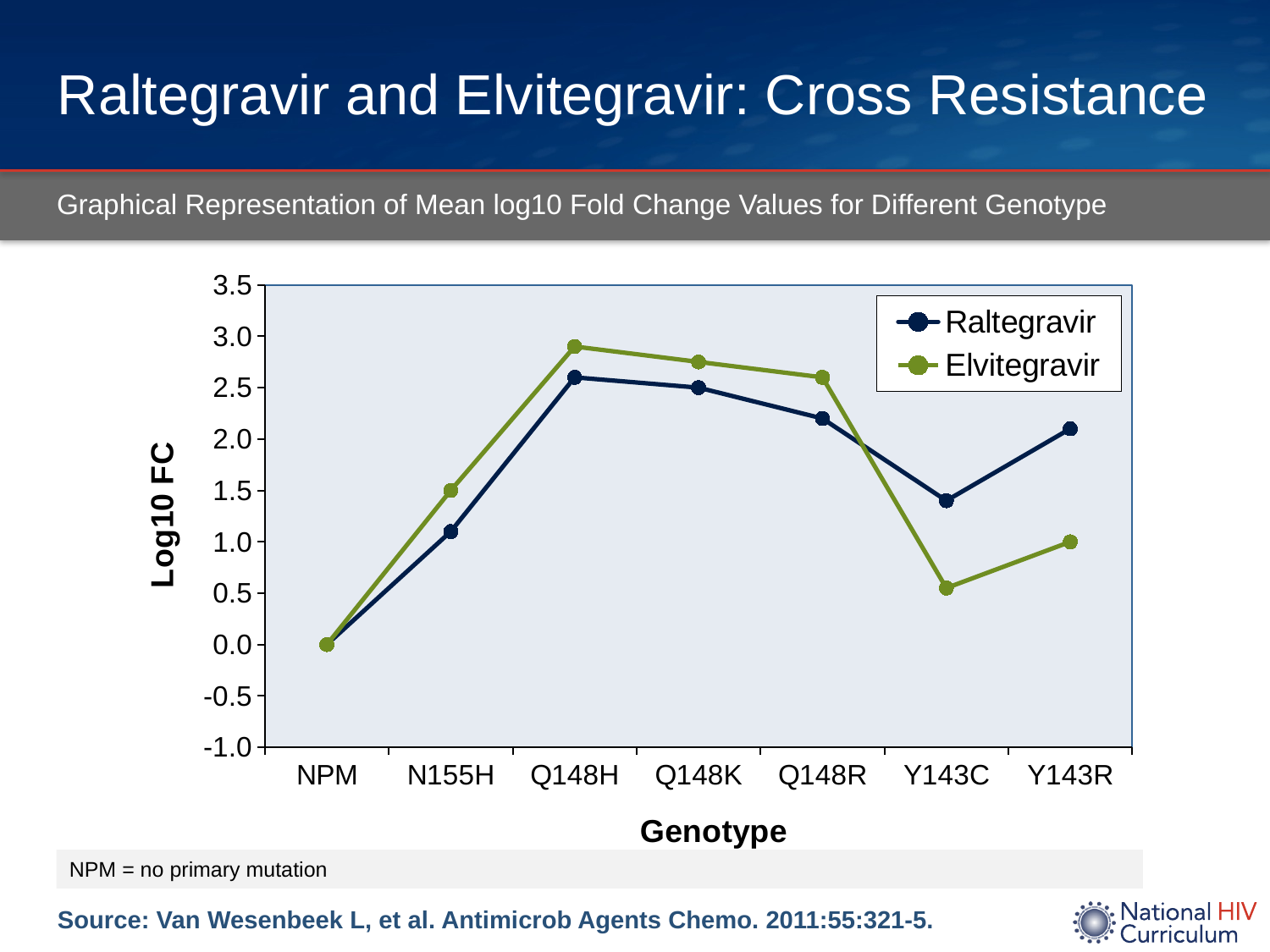
For which genotype is the Elvitegravir value highest? Q148H What is the Log10 FC value for Raltegravir at NPM? 0.0 Is the Elvitegravir value for Q148H greater or less than 2.5? greater Is the Elvitegravir value for Y143C greater or less than 1.0? less What kind of chart is shown on the slide? Line chart How many series does the legend list? 2 What is the title of the y axis? Log10 FC What is the Log10 FC value for Elvitegravir at N155H? 1.5 How many genotypes are plotted along the x axis? 7 For which genotype is the Raltegravir value lowest? NPM At Y143C, which series has the larger value, Raltegravir or Elvitegravir? Raltegravir What is the Log10 FC value for Elvitegravir at Y143R? 1.0